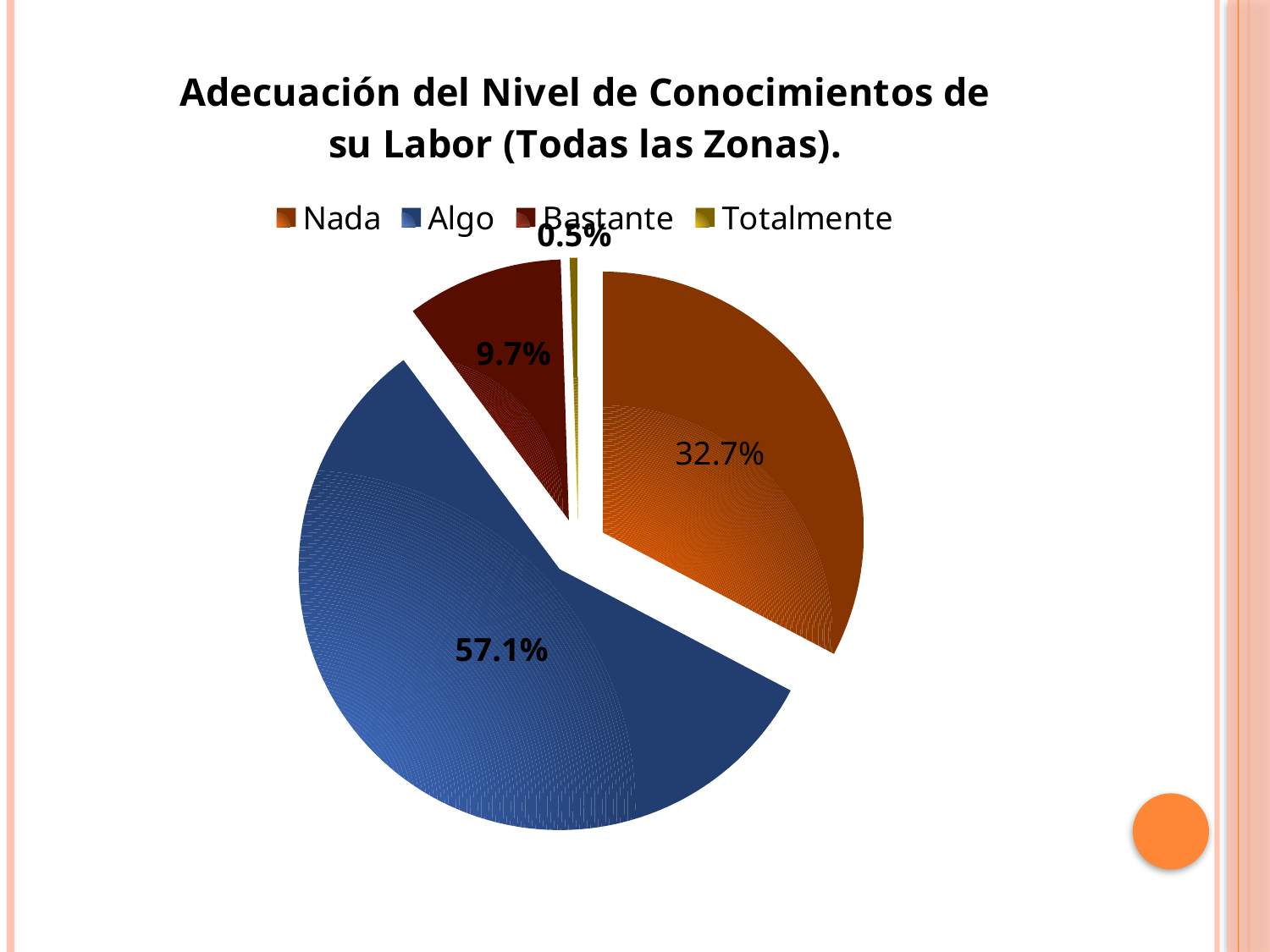
What percentage is shown for the Totalmente slice? 0.5% What percentage is shown for the Nada slice? 32.7% What colour is used for the Algo slice? Blue Which is larger, the Nada slice or the Bastante slice? Nada What kind of chart is shown on the slide? Pie chart What percentage is shown for the Algo slice? 57.1% How many categories does the legend list? 4 Which category has the largest share of the pie? Algo What is the difference in percentage points between the Algo and Nada slices? 24.4 What percentage is shown for the Bastante slice? 9.7% Which category has the smallest share of the pie? Totalmente What is the title of the chart? Adecuación del Nivel de Conocimientos de su Labor (Todas las Zonas).